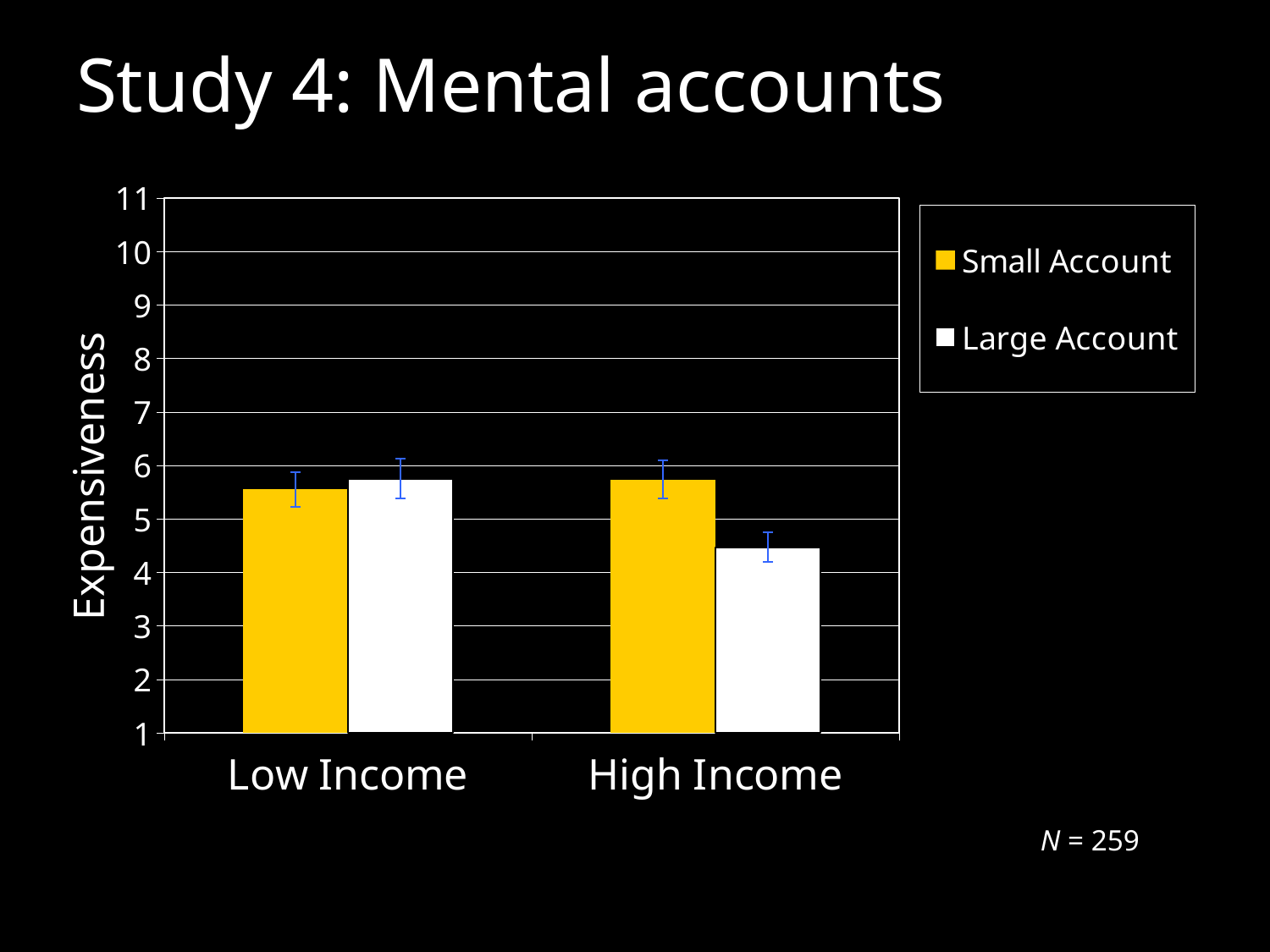
What kind of chart is shown on the slide? bar chart Is the value for Large Account in the Low Income group greater or less than 5? greater How many income categories are shown on the x axis? 2 Which bar is the lowest in the chart? Large Account, High Income Is the value for Large Account in the High Income group greater or less than 5? less Is the value for Small Account in the High Income group greater or less than 6? less Does the Large Account value rise or fall from Low Income to High Income? fall How many series does the legend list? 2 What is the label on the y axis? Expensiveness For High Income, which is larger: Small Account or Large Account? Small Account Which colour represents Small Account in the legend? yellow